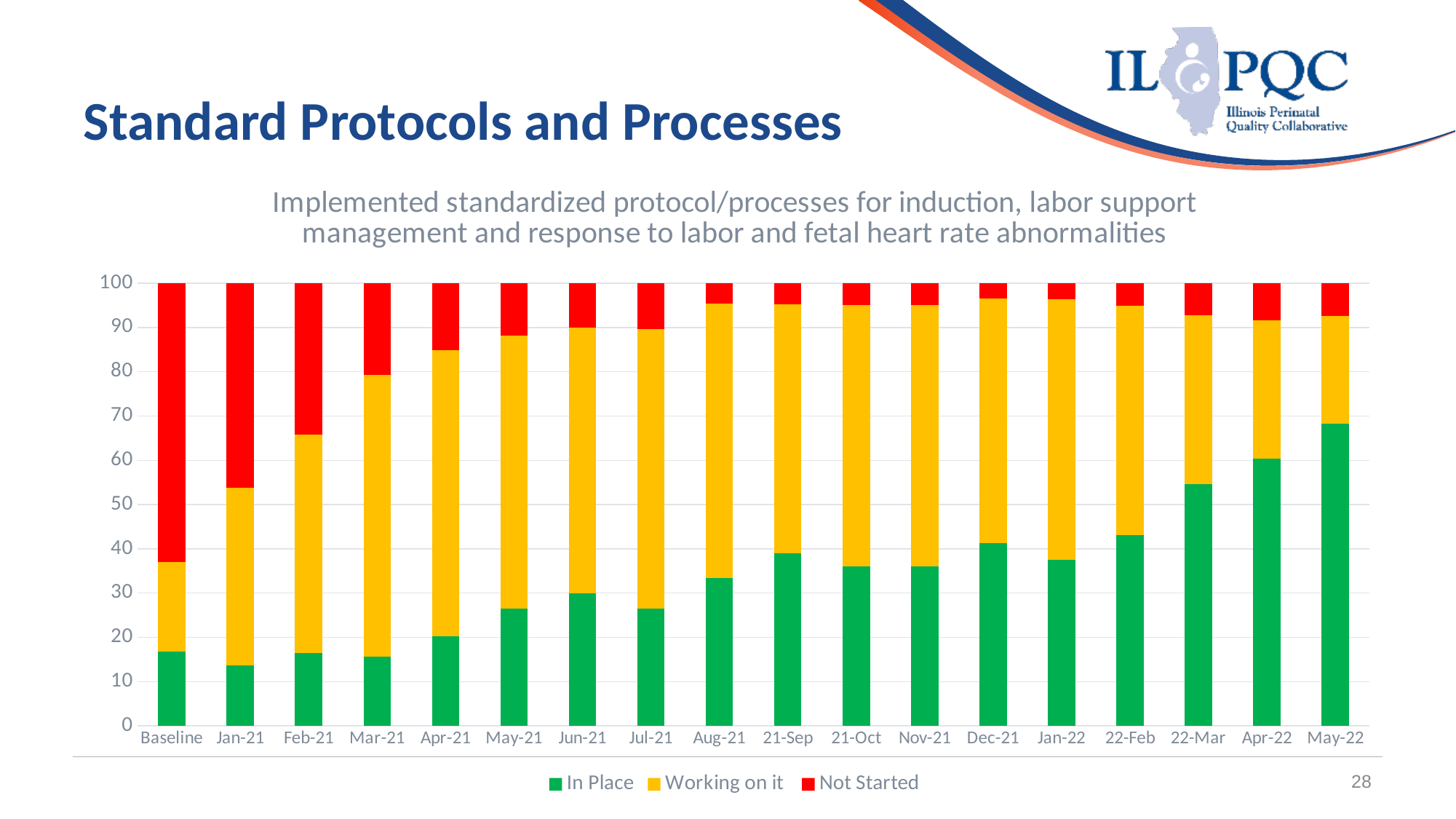
How many categories are shown along the x axis? 18 Which category has the highest 'In Place' value? May-22 Which category has the largest 'Not Started' segment? Baseline Is the 'In Place' value for Baseline greater or less than 20? less Which colour represents 'Not Started' in the legend? Red How many series does the legend list? 3 What kind of chart is shown on the slide? Stacked bar chart Does the 'In Place' series generally rise or fall from Baseline to May-22? rise What is the total height of the stacked bar for Baseline? 100 Is the 'In Place' value for May-22 greater or less than 60? greater Which has the larger 'In Place' value, Jan-22 or Apr-22? Apr-22 Is the 'In Place' value for 22-Mar greater or less than 50? greater